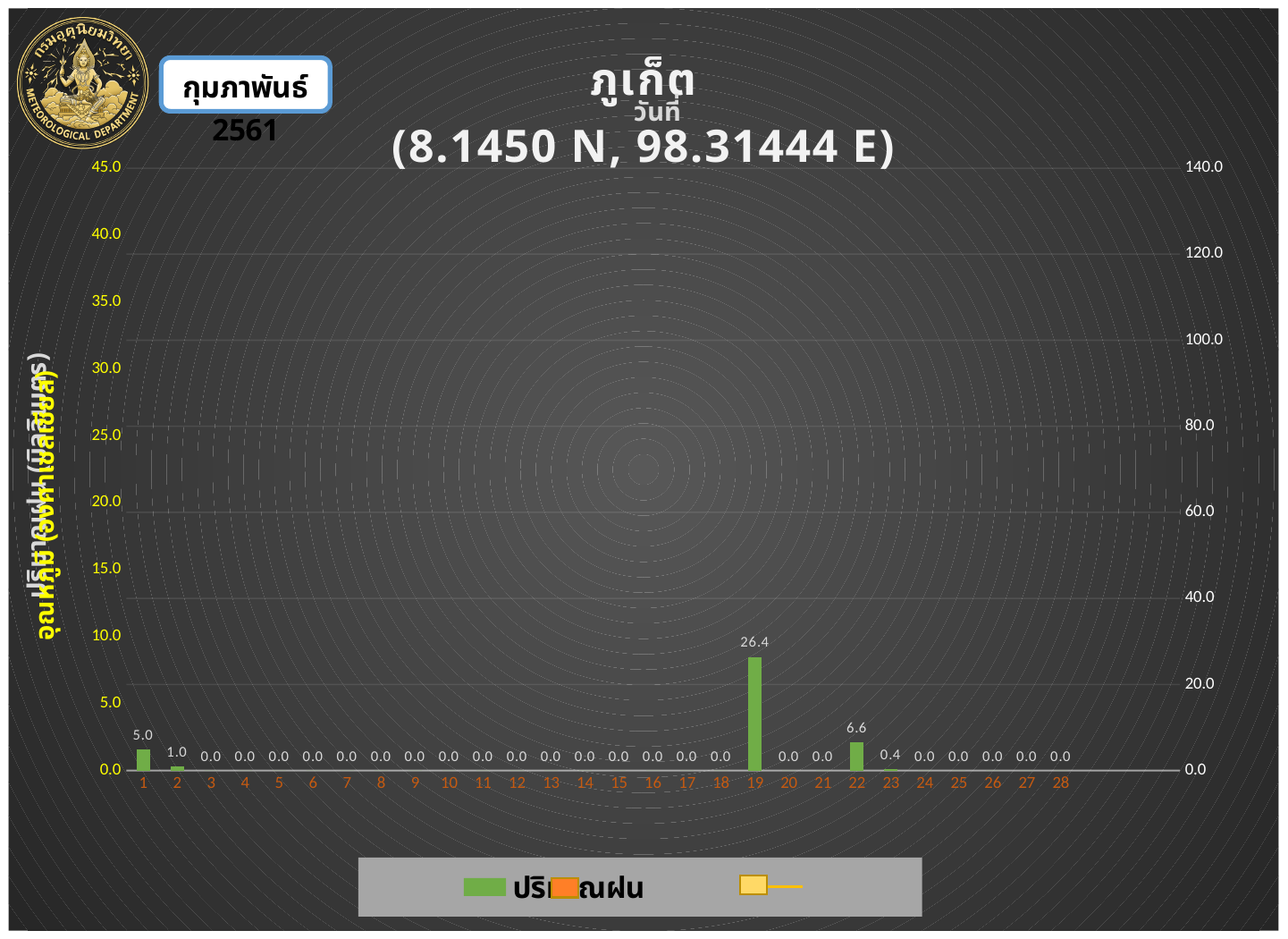
What is the difference between the rainfall values for day 19 and day 22? 19.8 What is the rainfall value for day 22? 6.6 Which day has the highest rainfall value? 19 What kind of chart is shown on the slide? bar chart What is the rainfall value for day 23? 0.4 What is the rainfall value for day 19? 26.4 How many days are shown on the x axis? 28 What colour are the rainfall bars in the chart? green What is the rainfall value for day 1? 5.0 Which has a larger rainfall value, day 1 or day 22? day 22 What is the highest value shown on the left vertical axis? 45.0 What is the difference between the rainfall values for day 1 and day 2? 4.0